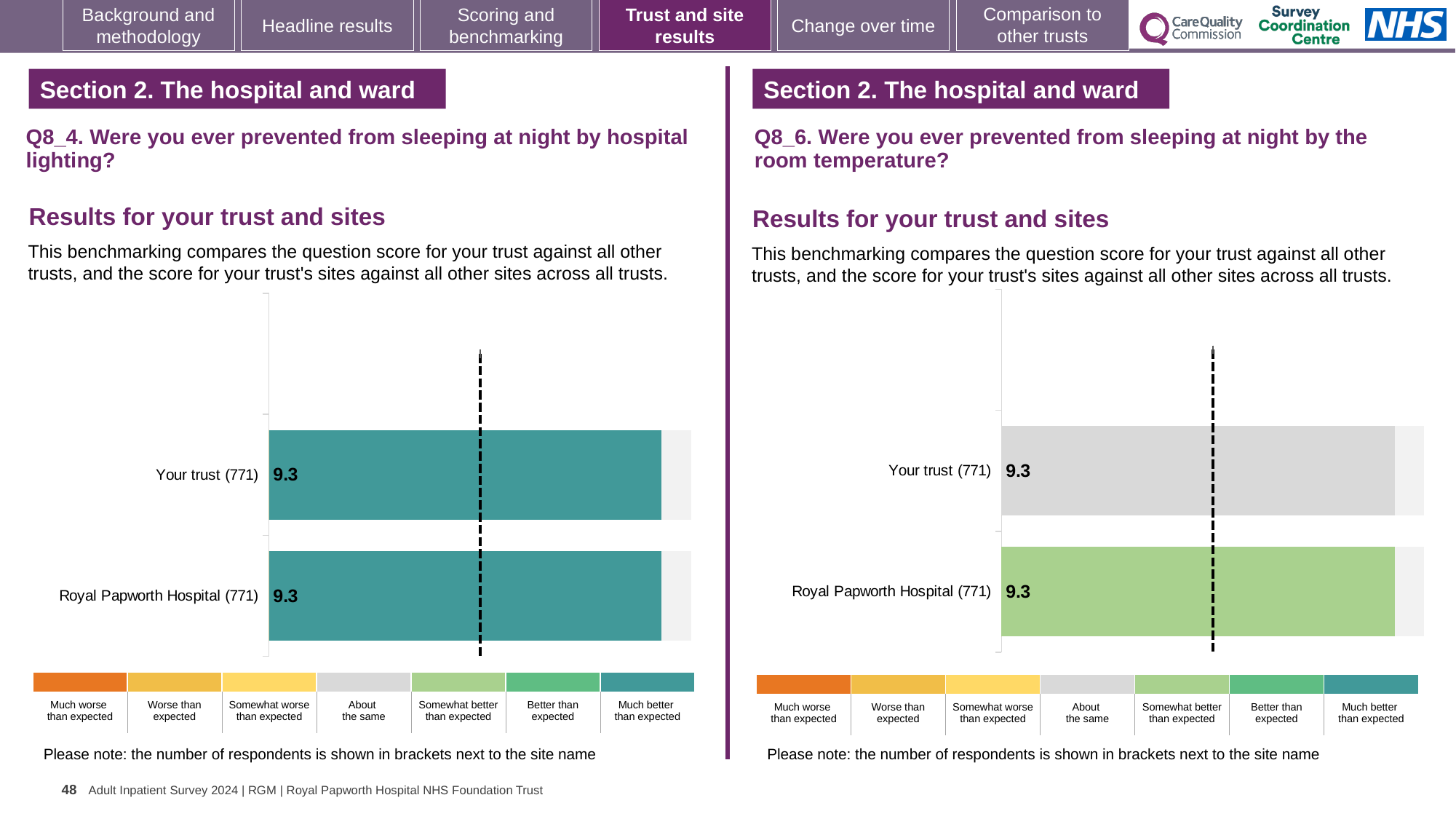
How many respondents are shown in brackets for Your trust in the Q8_6 chart (room temperature)? 771 In the Q8_6 chart (room temperature), which benchmark category does the colour of the Your trust bar correspond to? About the same In the Q8_4 chart (hospital lighting), what is the difference between the score for Your trust and the score for Royal Papworth Hospital? 0 In the Q8_6 chart (room temperature), what is the score for Royal Papworth Hospital (771)? 9.3 In the Q8_6 chart (room temperature), what is the difference between the score for Your trust and the score for Royal Papworth Hospital? 0 How many bars are plotted in the Q8_4 chart (hospital lighting)? 2 In the Q8_6 chart (room temperature), what is the score for Your trust (771)? 9.3 In the Q8_4 chart (hospital lighting), which benchmark category does the colour of the Royal Papworth Hospital bar correspond to? Much better than expected In the Q8_4 chart (hospital lighting), what is the score for Your trust (771)? 9.3 What type of chart is used for the Q8_4 results (hospital lighting)? Bar chart How many bars are plotted in the Q8_6 chart (room temperature)? 2 In the Q8_4 chart (hospital lighting), what is the score for Royal Papworth Hospital (771)? 9.3